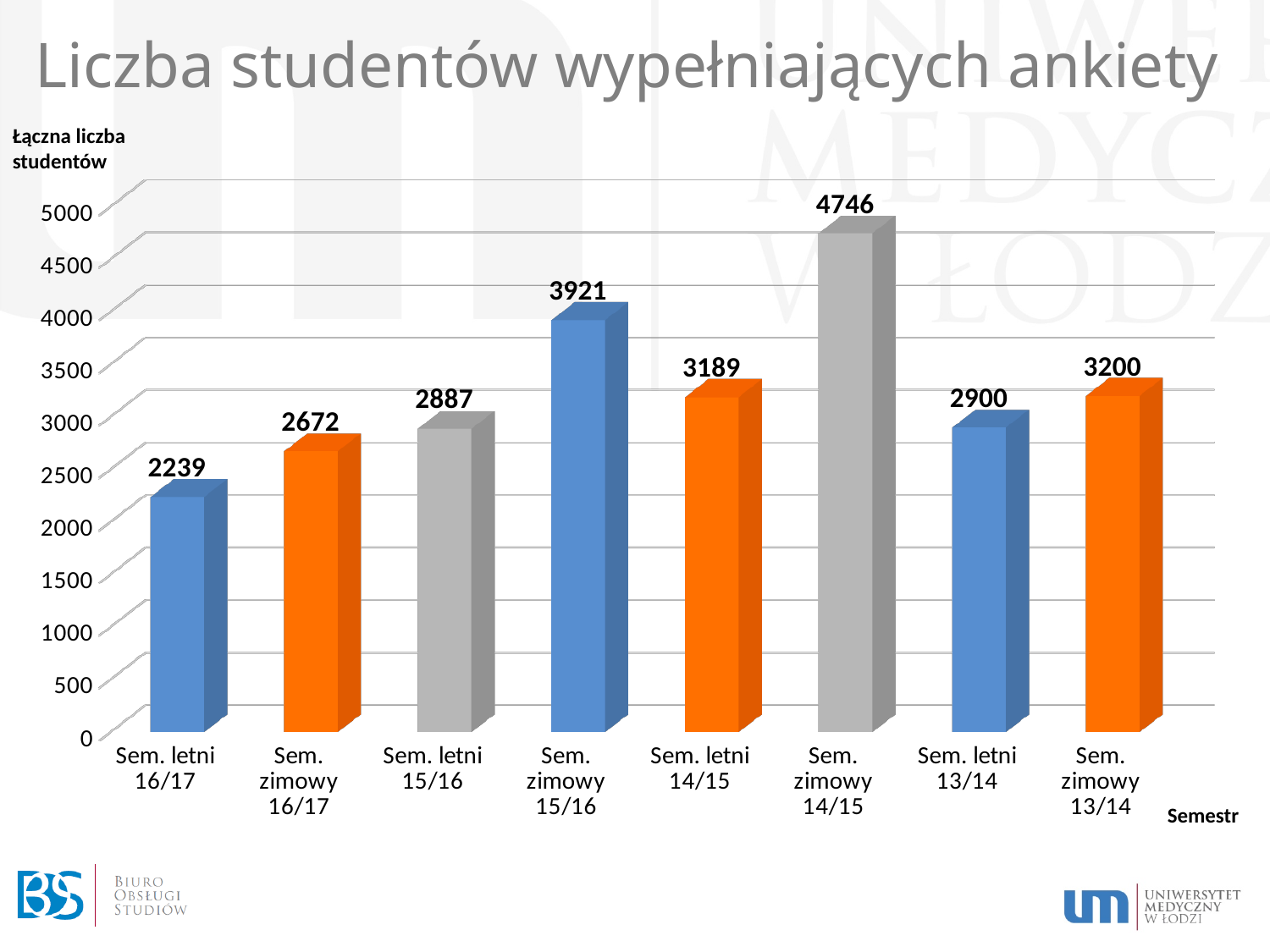
Is the value for Sem. zimowy 15/16 greater or less than 3500? greater What kind of chart is shown on the slide? bar chart What is the title of the slide? Liczba studentów wypełniających ankiety Which semester has the lowest number of students? Sem. letni 16/17 What is the value for Sem. zimowy 14/15? 4746 What is the difference between Sem. zimowy 15/16 and Sem. letni 15/16? 1034 Which is larger, Sem. zimowy 16/17 or Sem. letni 14/15? Sem. letni 14/15 Which semester has the highest number of students? Sem. zimowy 14/15 How many semesters are shown on the chart? 8 What is the value for Sem. letni 13/14? 2900 What is the difference between Sem. zimowy 13/14 and Sem. letni 13/14? 300 What is the value for Sem. letni 16/17? 2239